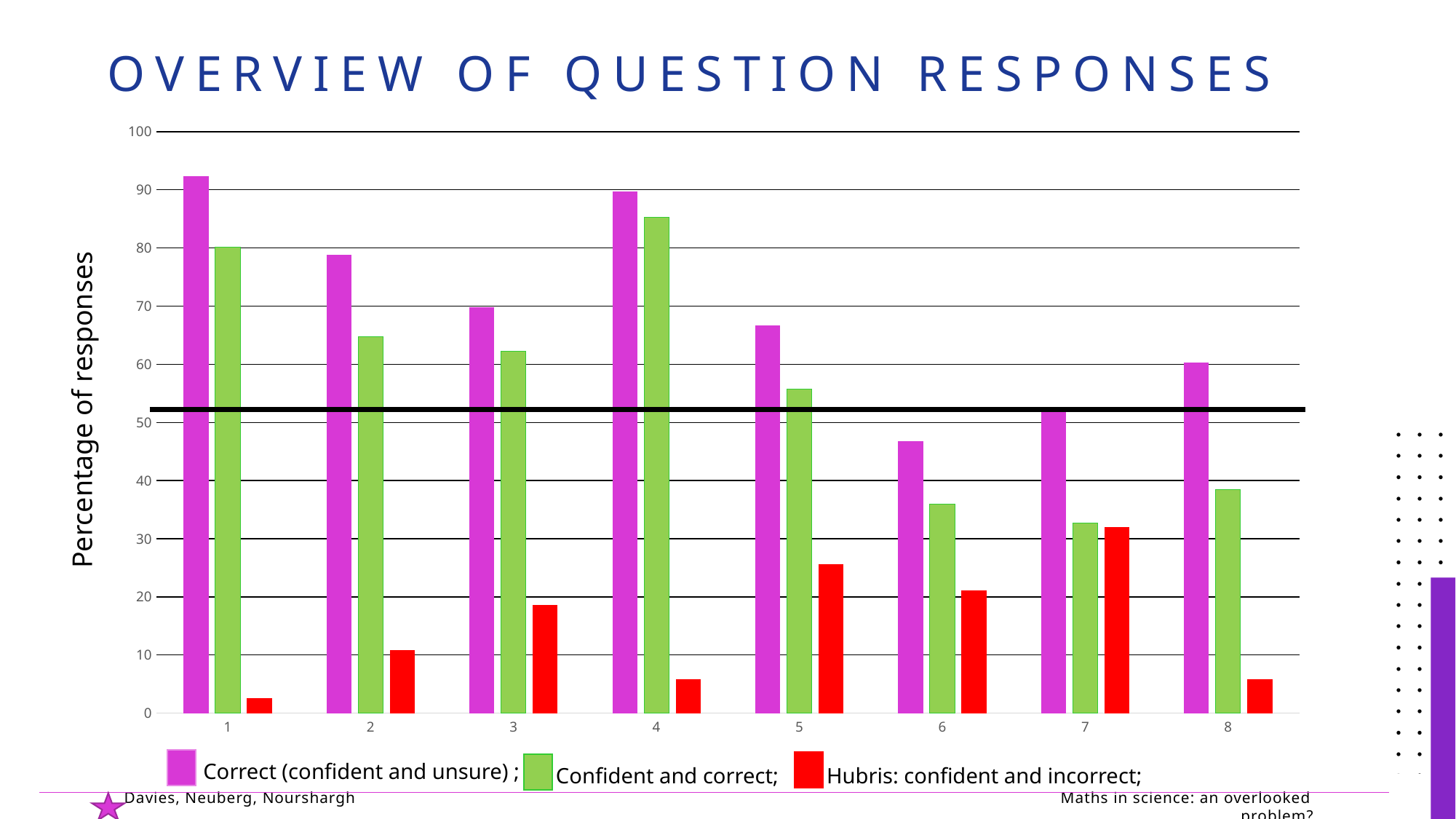
Which has the larger 'Correct (confident and unsure)' value, question 2 or question 3? Question 2 For which question is the 'Hubris: confident and incorrect' bar the highest? 7 What kind of chart is shown on the slide? Bar chart How many questions (categories) are shown along the x axis? 8 Is the 'Hubris: confident and incorrect' value for question 5 greater or less than 20? greater Is the 'Correct (confident and unsure)' value for question 1 greater or less than 80? greater For which question is the 'Correct (confident and unsure)' bar the lowest? 6 How many series does the legend list? 3 Is the 'Confident and correct' value for question 4 greater or less than 80? greater What is the label on the y axis? Percentage of responses Do the 'Hubris: confident and incorrect' values rise or fall from question 1 to question 3? Rise For which question is the 'Hubris: confident and incorrect' bar the lowest? 1